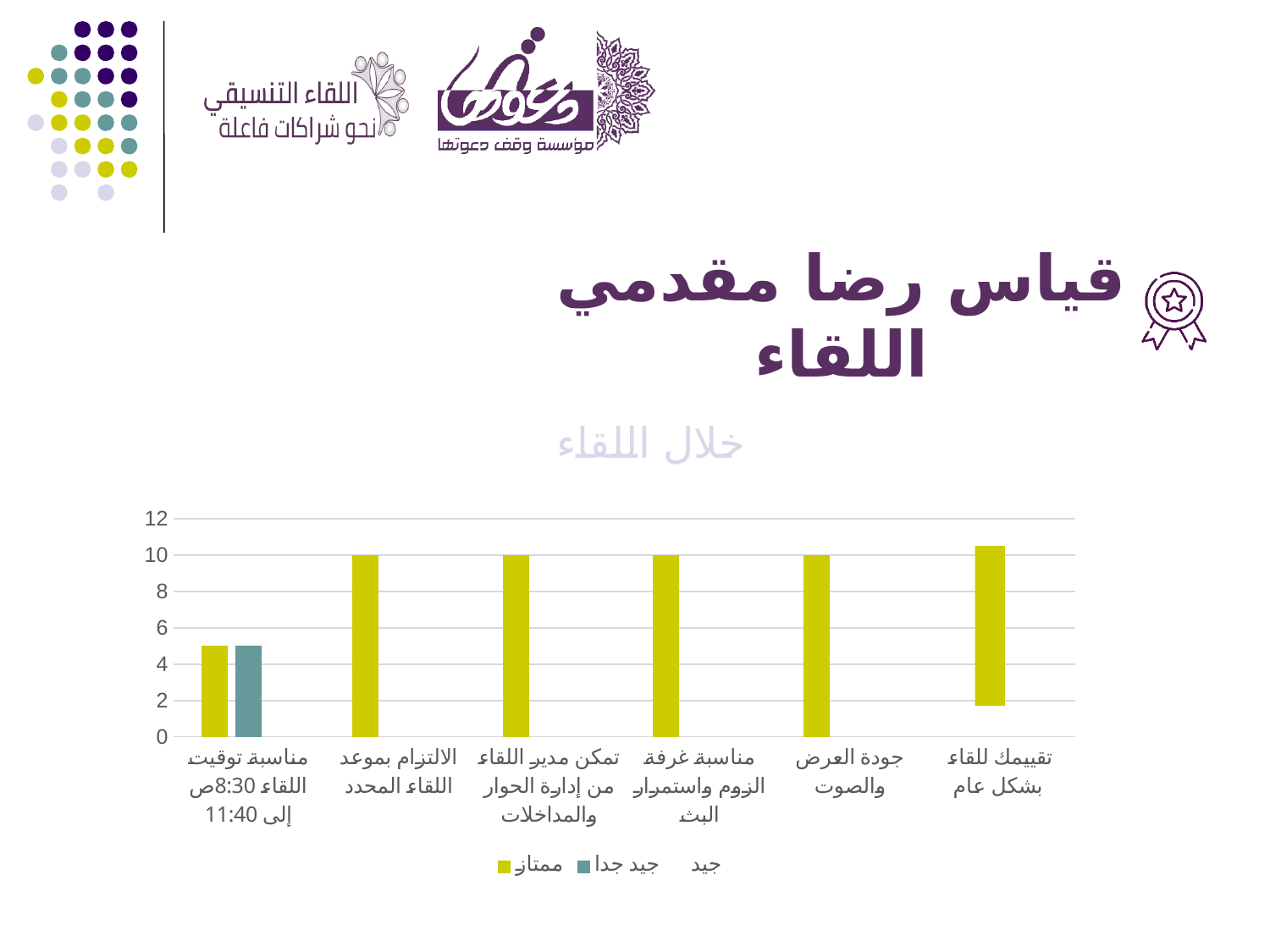
What kind of chart is shown on the slide? bar chart Is the جيد جدا value for مناسبة توقيت اللقاء 8:30ص إلى 11:40 greater or less than 4? greater Is the ممتاز value for مناسبة توقيت اللقاء 8:30ص إلى 11:40 greater or less than 8? less How many series does the chart legend list? 3 Which has a larger ممتاز value: جودة العرض والصوت or مناسبة توقيت اللقاء 8:30ص إلى 11:40? جودة العرض والصوت What is the value of the ممتاز bar for جودة العرض والصوت? 10 What is the value of the ممتاز bar for مناسبة غرفة الزوم واستمرار البث? 10 Which category has the lowest ممتاز bar? مناسبة توقيت اللقاء 8:30ص إلى 11:40 What colour represents the ممتاز series in the chart? yellow How many categories are shown on the x axis of the chart? 6 What is the value of the ممتاز bar for الالتزام بموعد اللقاء المحدد? 10 What is the title of the chart? خلال اللقاء